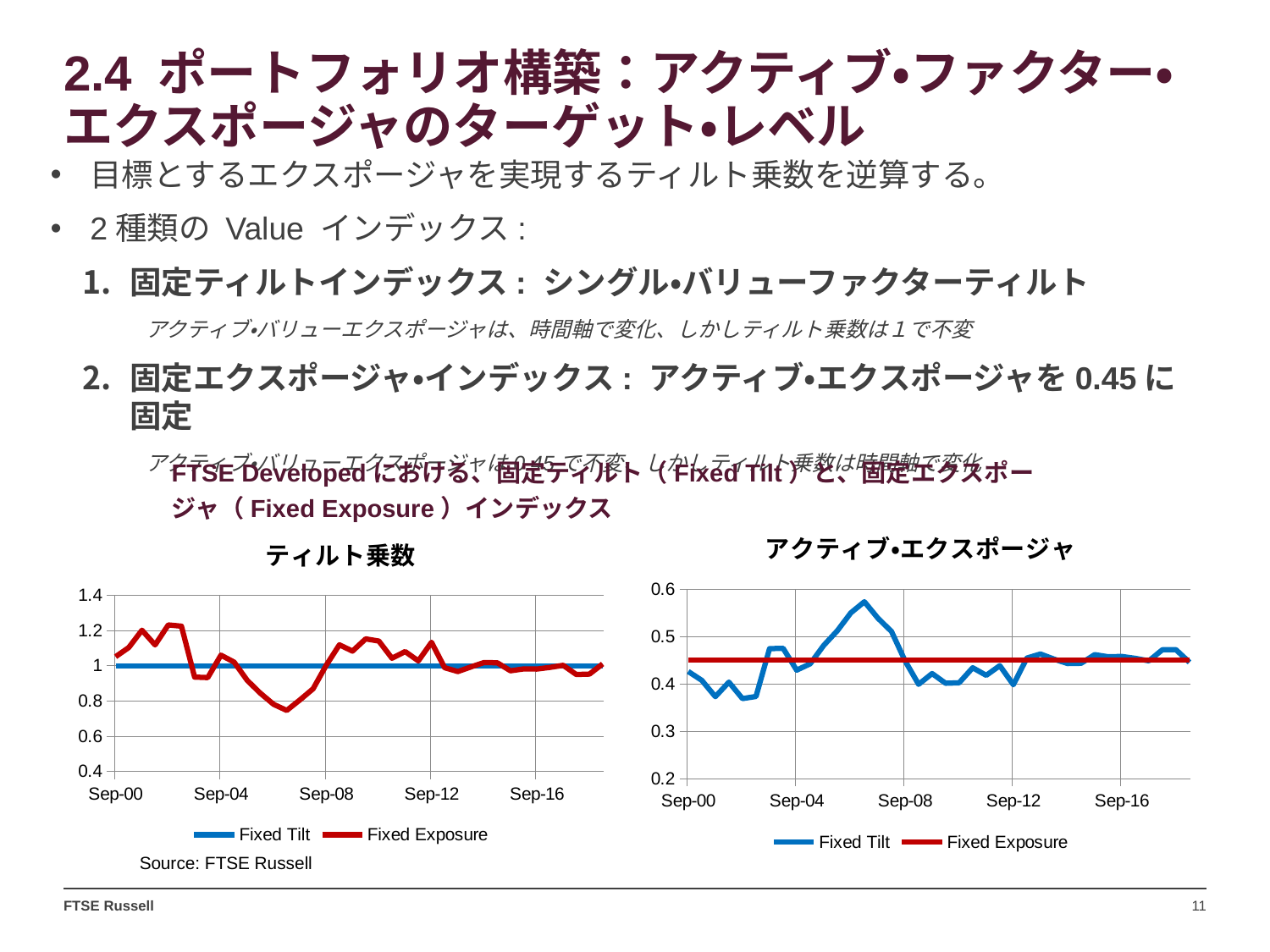
In the アクティブ•エクスポージャ chart, is the constant Fixed Exposure line greater or less than 0.4? greater What kind of chart is the アクティブ•エクスポージャ chart on the right? line chart In the ティルト乗数 chart, is the lowest value of the Fixed Exposure series (around 2007) greater or less than 0.8? less In the ティルト乗数 chart, is the peak of the Fixed Exposure series around 2003 greater or less than 1? greater In the ティルト乗数 chart, what is the value of the Fixed Tilt series across the whole period? 1 How many series does the legend of the ティルト乗数 chart list? 2 In the アクティブ•エクスポージャ chart, which series is drawn in red? Fixed Exposure In the ティルト乗数 chart, around Sep-07, which series is higher: Fixed Tilt or Fixed Exposure? Fixed Tilt How many x-axis tick labels are shown on the アクティブ•エクスポージャ chart? 5 In the ティルト乗数 chart, does the Fixed Tilt series rise, fall or stay flat over time? stays flat What kind of chart is the ティルト乗数 chart on the left? line chart